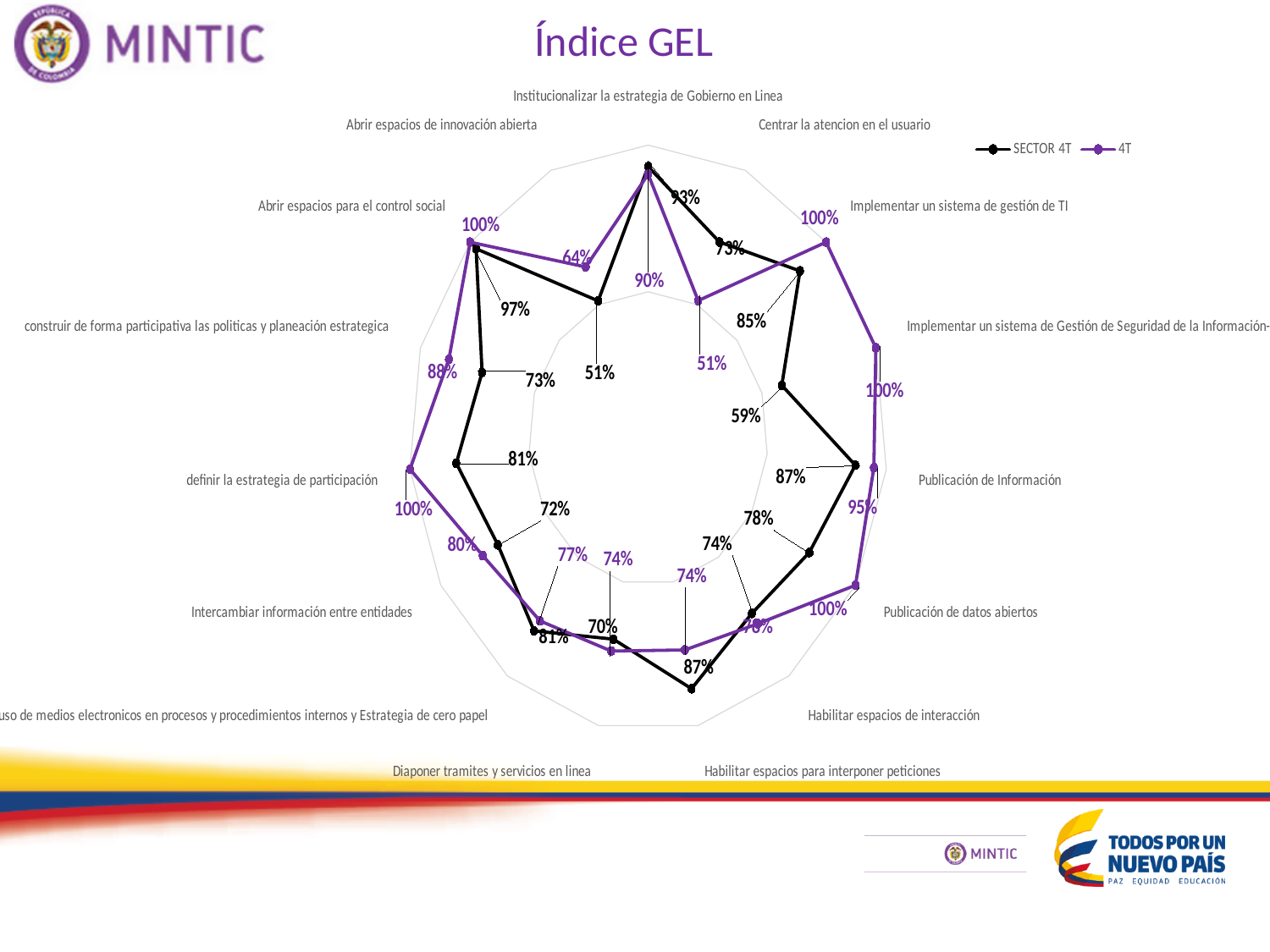
How many categories (axes) does the radar chart have? 15 Which category has the lowest SECTOR 4T value? Abrir espacios de innovación abierta What is the SECTOR 4T value for 'Abrir espacios para el control social'? 97% What is the 4T value for 'Implementar un sistema de gestión de TI'? 100% What is the SECTOR 4T value for 'Publicación de Información'? 87% What is the 4T value for 'Abrir espacios de innovación abierta'? 64% What is the difference between the 4T and SECTOR 4T values for 'Publicación de Información'? 8 percentage points How many series does the legend list? 2 What kind of chart is shown on the slide? Radar chart What is the 4T value for 'Publicación de Información'? 95% What are the two series named in the legend? SECTOR 4T and 4T For 'Publicación de Información', which series has the larger value, SECTOR 4T or 4T? 4T